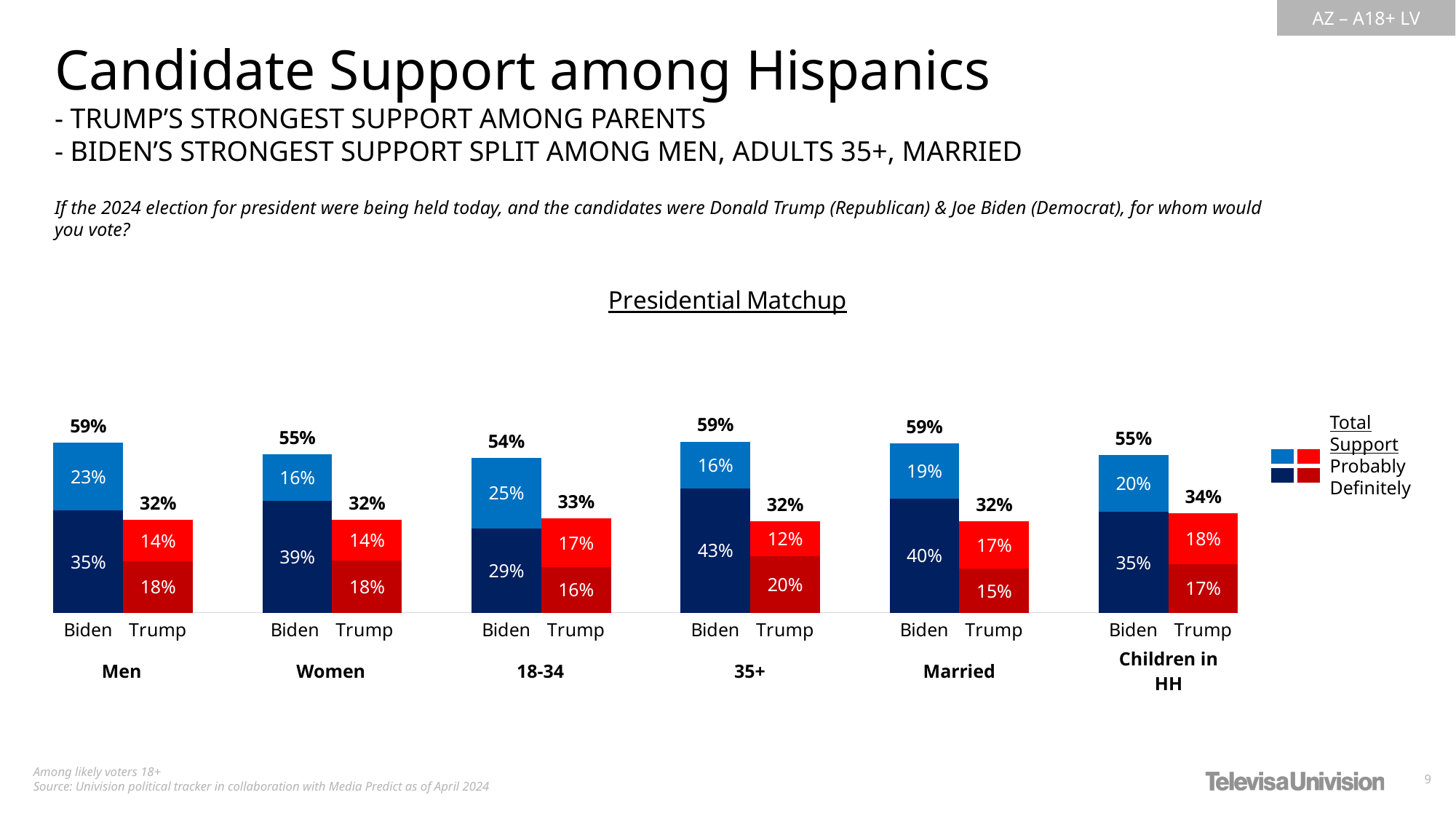
What is the 'Definitely' support for Biden among adults 35+? 43% Among 18-34 voters, which candidate has the higher total support, Biden or Trump? Biden What is the 'Definitely' support for Trump among adults 35+? 20% What is the sum of the 'Definitely' and 'Probably' segments for Trump among Women? 32% What kind of chart is used for the Presidential Matchup? Stacked bar chart What is the 'Probably' support for Biden among Women? 16% How many demographic groups are shown in the chart? 6 What is the total support for Biden among Men? 59% What is the difference between Biden's and Trump's total support among Married voters? 27% Which group shows the highest total support for Trump? Children in HH Which group shows the lowest total support for Biden? 18-34 What two levels of support does the legend distinguish? Probably and Definitely